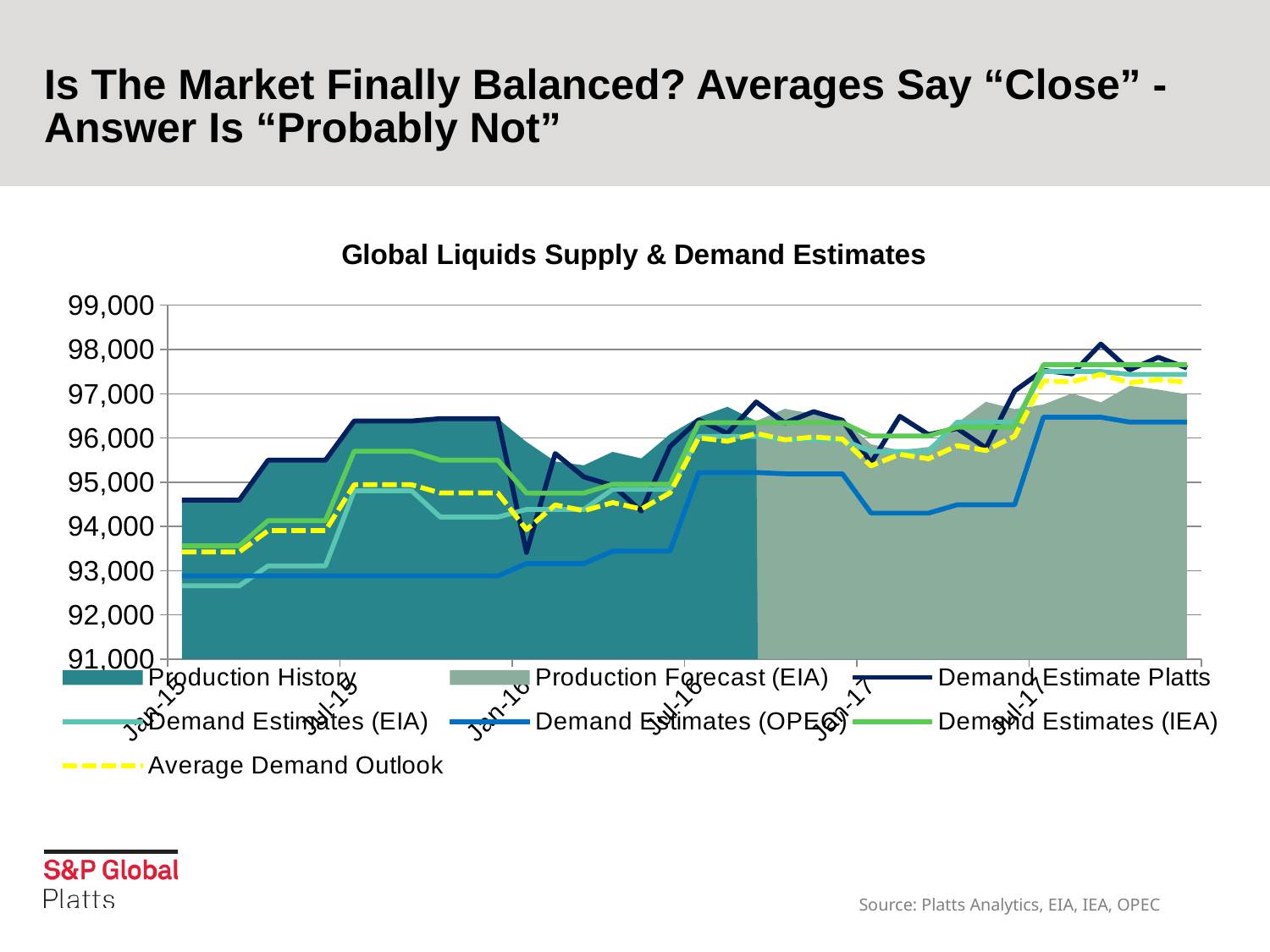
How many series does the chart's legend list? 7 At Jul-17, which is larger: Demand Estimate Platts or Demand Estimates (OPEC)? Demand Estimate Platts Which series is drawn as a yellow dashed line? Average Demand Outlook What is the title of the chart? Global Liquids Supply & Demand Estimates Is the value for Demand Estimates (OPEC) at Jul-17 greater or less than 97,000? less At Jan-15, which is larger: Demand Estimate Platts or Demand Estimates (OPEC)? Demand Estimate Platts Does the Demand Estimates (OPEC) series generally rise or fall from Jan-15 to Jul-17? rise Is the value for Demand Estimate Platts at Jan-15 greater or less than 94,000? greater Is the value for Average Demand Outlook at Jul-17 greater or less than 97,000? greater What kind of chart is shown on the slide? Area and line chart